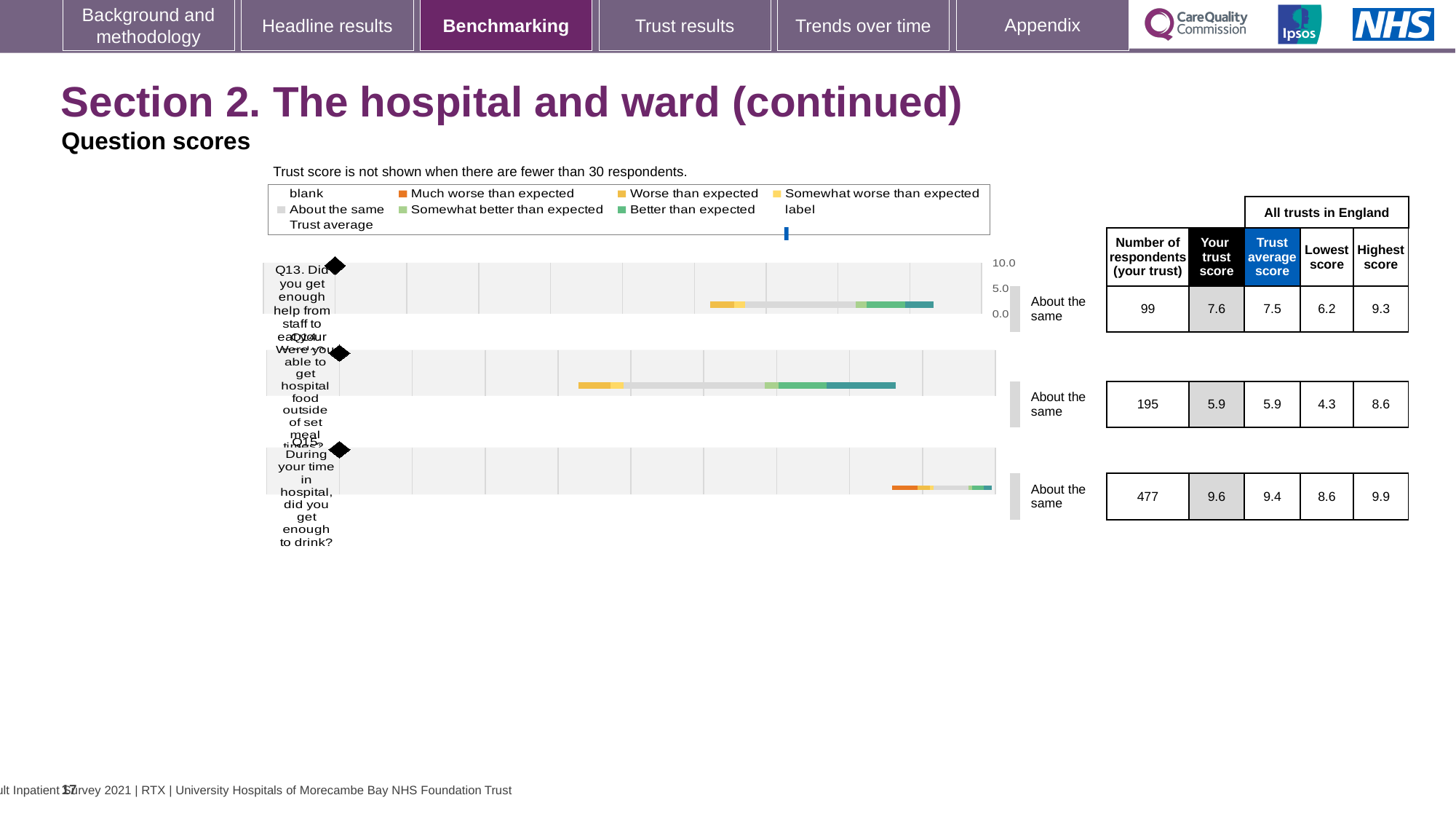
For Q15, which is larger: your trust score or the trust average score? Your trust score What is the highest score across all trusts in England for Q14? 8.6 How many questions are charted on this slide? 3 Which question has the lowest number of respondents at your trust? Q13 How many respondents answered Q14 (Were you able to get hospital food outside of set meal times?) at your trust? 195 For Q14, what is the difference between the highest score and the lowest score across all trusts in England? 4.3 What is the lowest score across all trusts in England for Q13? 6.2 For Q13, what is the difference between your trust score and the trust average score? 0.1 What is the trust average score for Q15 (During your time in hospital, did you get enough to drink?)? 9.4 What kind of chart is used to show the question scores on this slide? Bar chart Which question has the highest 'Your trust score' on this slide? Q15 What is the 'Your trust score' for Q13 (Did you get enough help from staff to eat your meals?)? 7.6